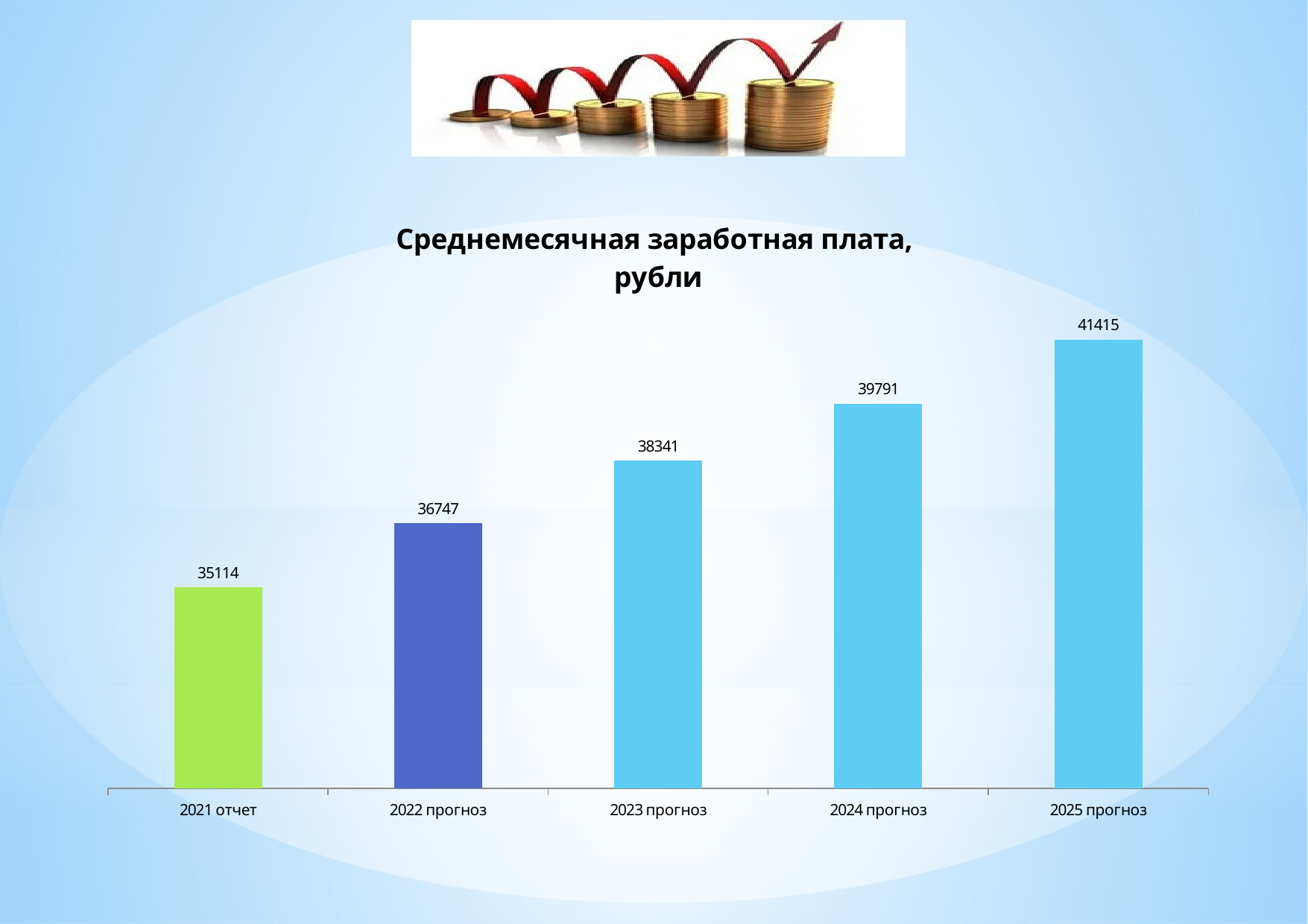
What is the value for 2025 прогноз? 41415 Do the values rise or fall from 2021 отчет to 2025 прогноз? rise What is the value for 2023 прогноз? 38341 Which is larger, the value for 2022 прогноз or the value for 2024 прогноз? 2024 прогноз What is the difference between the values for 2025 прогноз and 2021 отчет? 6301 What is the difference between the values for 2024 прогноз and 2023 прогноз? 1450 What is the value for 2021 отчет? 35114 What kind of chart is this? bar chart Which category has the lowest value? 2021 отчет How many categories are shown on the x axis? 5 Which category has the highest value? 2025 прогноз What is the title of the chart? Среднемесячная заработная плата, рубли